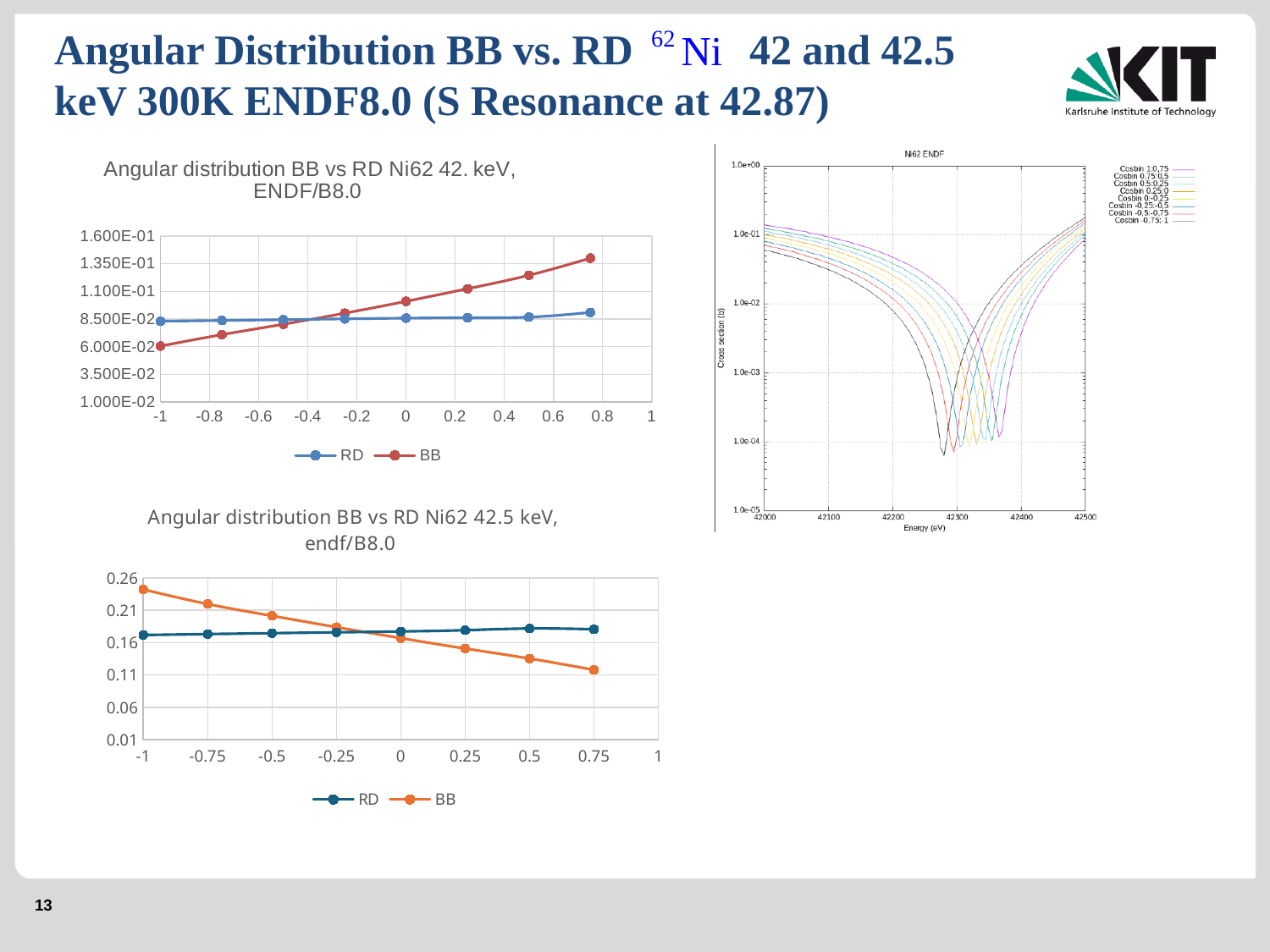
In the right-hand chart titled 'Ni62 ENDF', how many series does the legend list? 8 In the top-left chart (Ni62 42. keV), which series has the larger value at x = -1, RD or BB? RD In the top-left chart (Ni62 42. keV), is the BB value at x = -1 greater or less than 8.500E-02? less In the bottom-left chart (Ni62 42.5 keV), is the BB value at x = -1 greater or less than 0.21? greater In the top-left chart (Ni62 42. keV), how many series does the legend list? 2 In the bottom-left chart (Ni62 42.5 keV), does the BB series rise or fall as the x value increases from -1 to 0.75? Fall What kind of chart is the top-left chart titled 'Angular distribution BB vs RD Ni62 42. keV, ENDF/B8.0'? Line chart In the top-left chart (Ni62 42. keV), is the BB value at x = 0.75 greater or less than 1.100E-01? greater In the top-left chart (Ni62 42. keV), how many data points does the BB series have? 8 What is the x-axis label of the right-hand chart titled 'Ni62 ENDF'? Energy (eV) In the bottom-left chart (Ni62 42.5 keV), which series has the larger value at x = 0.75, RD or BB? RD In the top-left chart (Ni62 42. keV), does the BB series rise or fall as the x value increases from -1 to 0.75? Rise